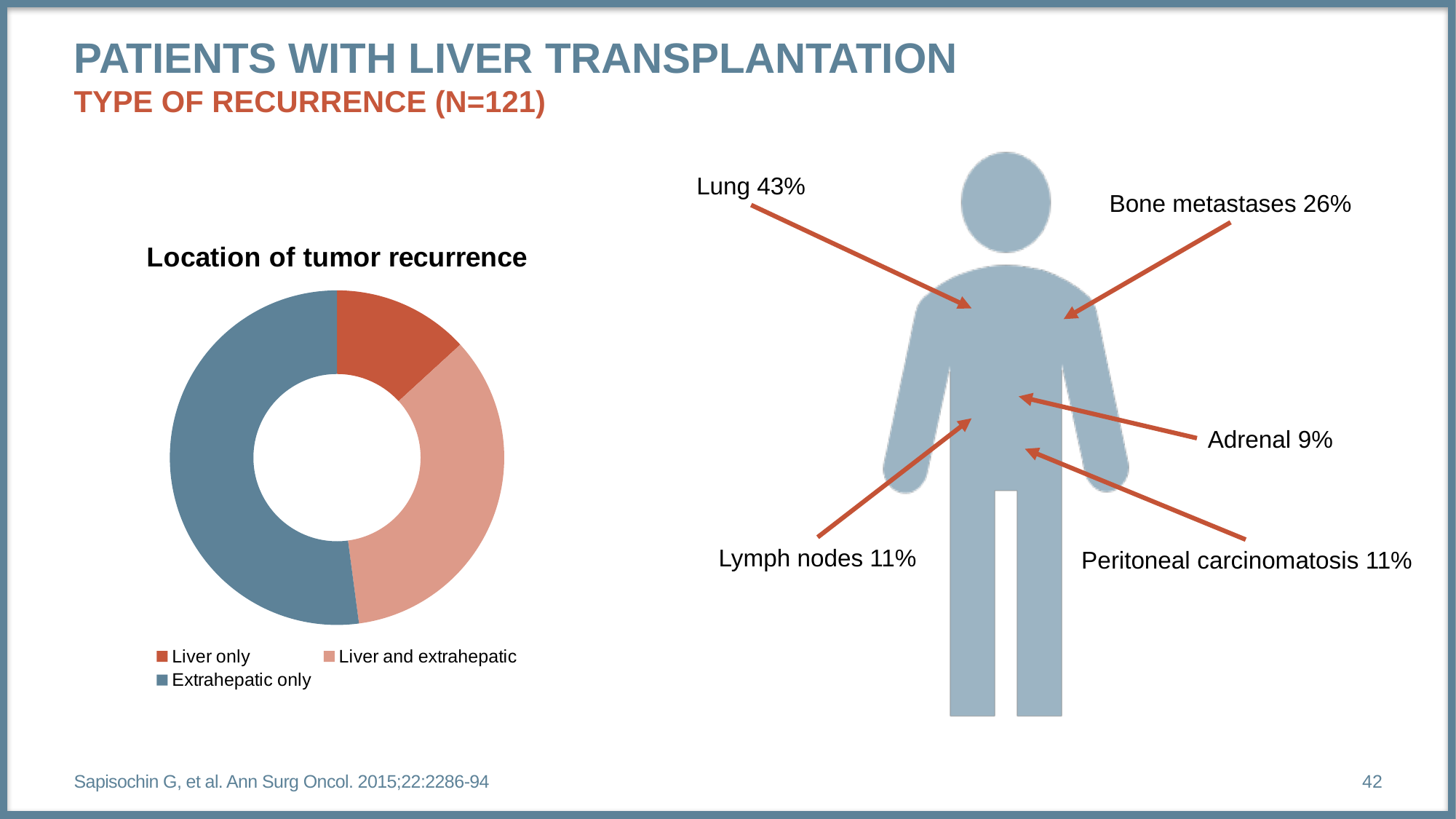
What is the title of the donut chart on the left of the slide? Location of tumor recurrence In the body diagram on the right, which site has the lowest percentage? Adrenal How many categories does the 'Location of tumor recurrence' chart show? 3 In the body diagram on the right, what percentage is given for Bone metastases? 26% What type of chart is 'Location of tumor recurrence'? Pie chart (donut) In the body diagram on the right, what percentage is given for Lung? 43% In the 'Location of tumor recurrence' chart, which category is shown in the dark red-orange colour? Liver only How many entries does the legend of the 'Location of tumor recurrence' chart list? 3 In the 'Location of tumor recurrence' chart, which category has the smallest share? Liver only In the 'Location of tumor recurrence' chart, which category has the largest share? Extrahepatic only In the 'Location of tumor recurrence' chart, which is larger: Liver only or Liver and extrahepatic? Liver and extrahepatic In the 'Location of tumor recurrence' chart, which is larger: Extrahepatic only or Liver and extrahepatic? Extrahepatic only